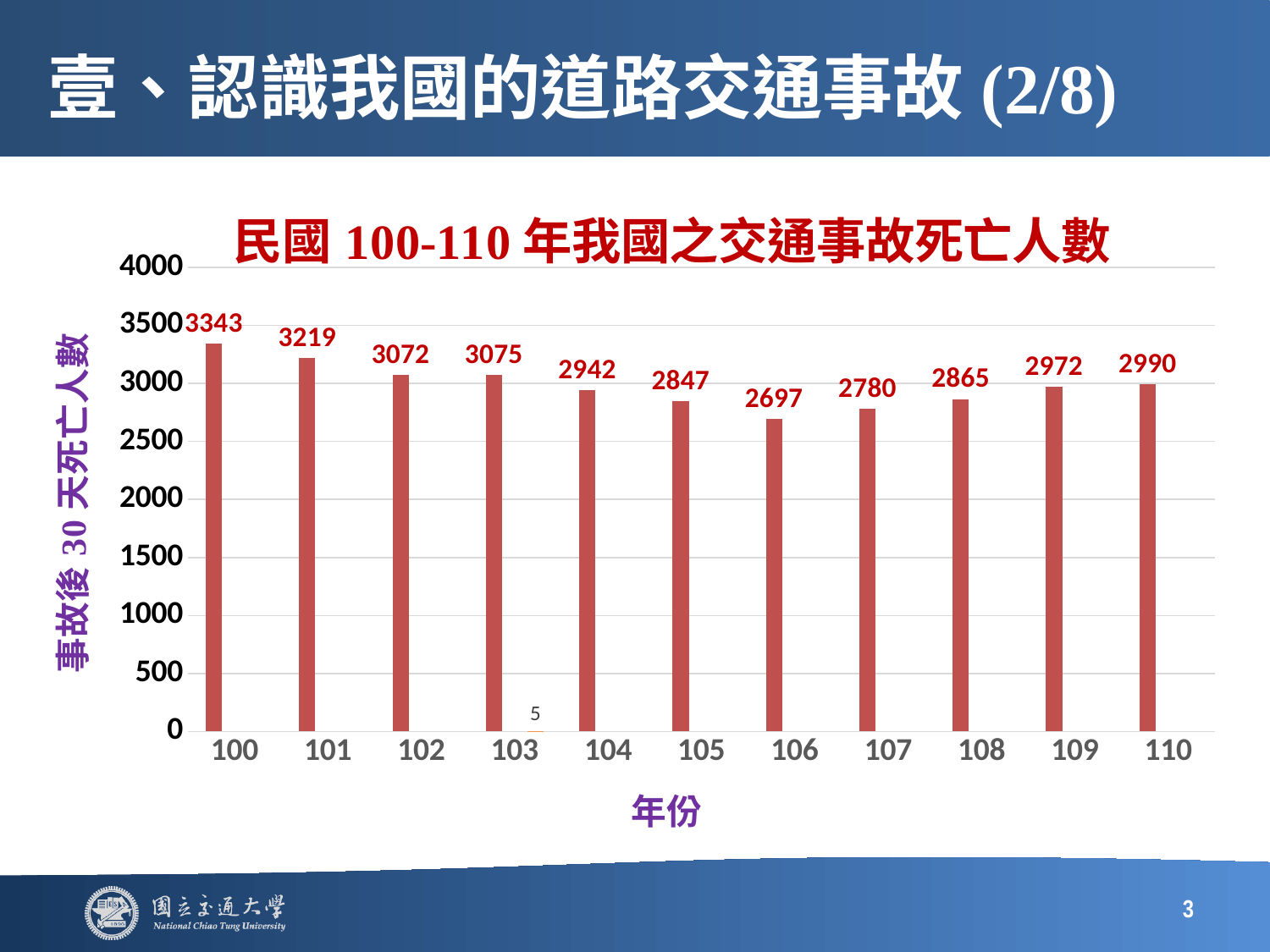
What is the difference in deaths between year 110 and year 106? 293 What is the number of traffic accident deaths for year 106? 2697 What is the difference in deaths between year 100 and year 101? 124 What is the number of traffic accident deaths for year 110? 2990 How many years are shown on the x axis of the chart? 11 Which year has more traffic accident deaths, 104 or 108? 104 Which year has the highest number of traffic accident deaths? 100 What is the label of the x axis of the chart? 年份 Which year has the lowest number of traffic accident deaths? 106 What kind of chart is shown on the slide? bar chart What is the number of traffic accident deaths for year 100? 3343 Is the value for year 107 greater or less than 3000? less